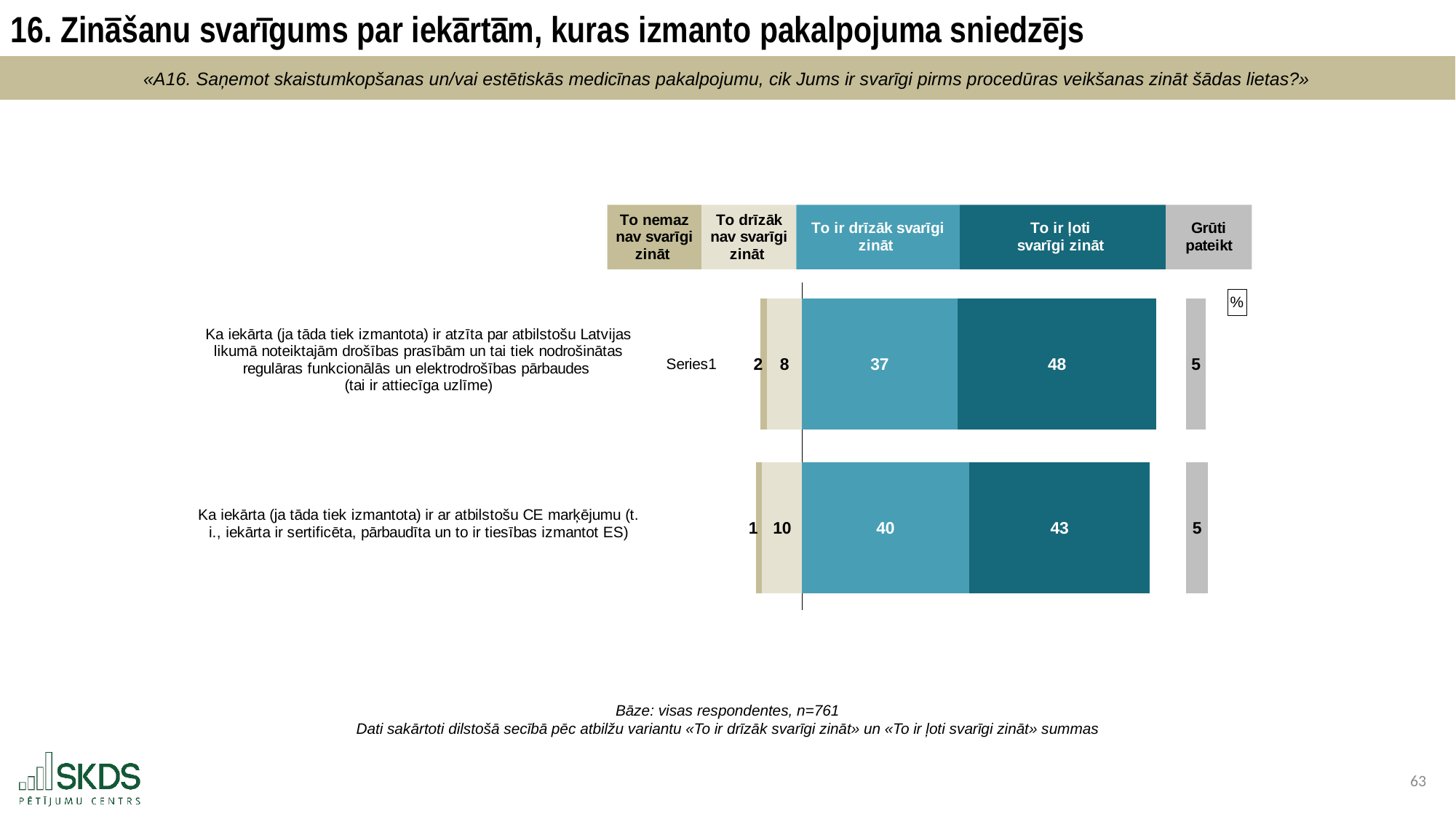
What is the value for "To ir drīzāk svarīgi zināt" in the bar about the equipment having CE marking (second bar)? 40 What is the value for "Grūti pateikt" in the first bar (Latvian safety requirements)? 5 Which segment is the largest in the first bar (Latvian safety requirements)? To ir ļoti svarīgi zināt How many series does the legend list? 5 Which segment is the smallest in the second bar (CE marking)? To nemaz nav svarīgi zināt What is the difference between the "To ir ļoti svarīgi zināt" values of the first bar (48) and the second bar (43)? 5 What is the value for "To drīzāk nav svarīgi zināt" in the bar about CE marking (second bar)? 10 Which bar has the larger "To ir drīzāk svarīgi zināt" value: the first bar (Latvian safety requirements) or the second bar (CE marking)? the second bar (CE marking) How many bars (statements) are plotted in the chart? 2 What is the total of all segments in the second bar (CE marking)? 99 What kind of chart is shown on the slide? stacked bar chart What is the value for "To ir ļoti svarīgi zināt" in the bar about the equipment meeting Latvian safety requirements (first bar)? 48